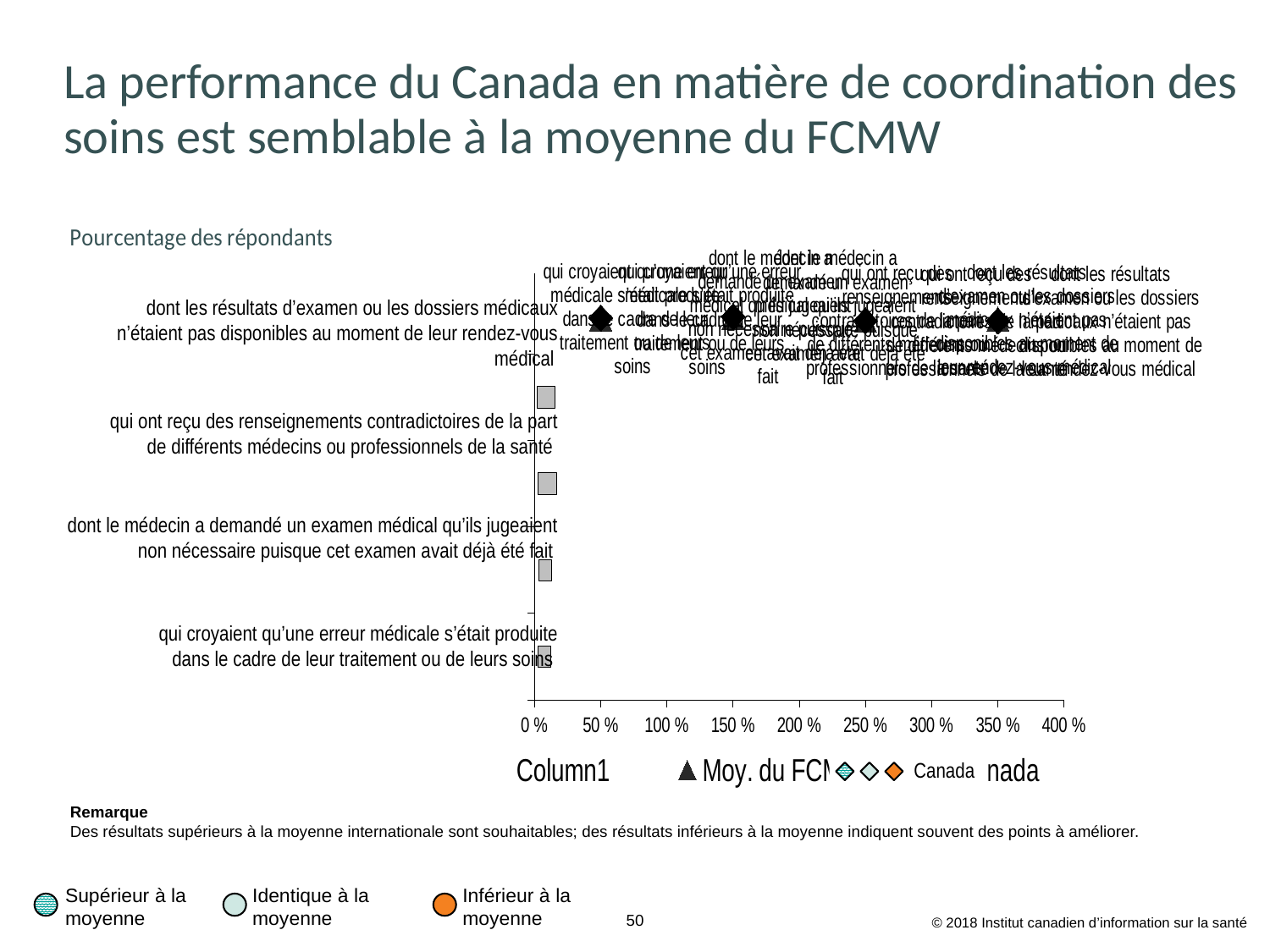
Is the bar for 'qui croyaient qu'une erreur médicale s'était produite dans le cadre de leur traitement ou de leurs soins' greater or less than 100 %? less How many categories are listed on the vertical axis of the chart? 4 Is the bar for 'dont le médecin a demandé un examen médical qu'ils jugeaient non nécessaire puisque cet examen avait déjà été fait' greater or less than 50 %? less How many series does the chart legend list? 4 Is the bar for 'qui ont reçu des renseignements contradictoires de la part de différents médecins ou professionnels de la santé' greater or less than 50 %? less What kind of chart is shown on the slide? bar chart What is the highest value shown on the horizontal axis of the chart? 400 % What is the title of the chart slide? La performance du Canada en matière de coordination des soins est semblable à la moyenne du FCMW